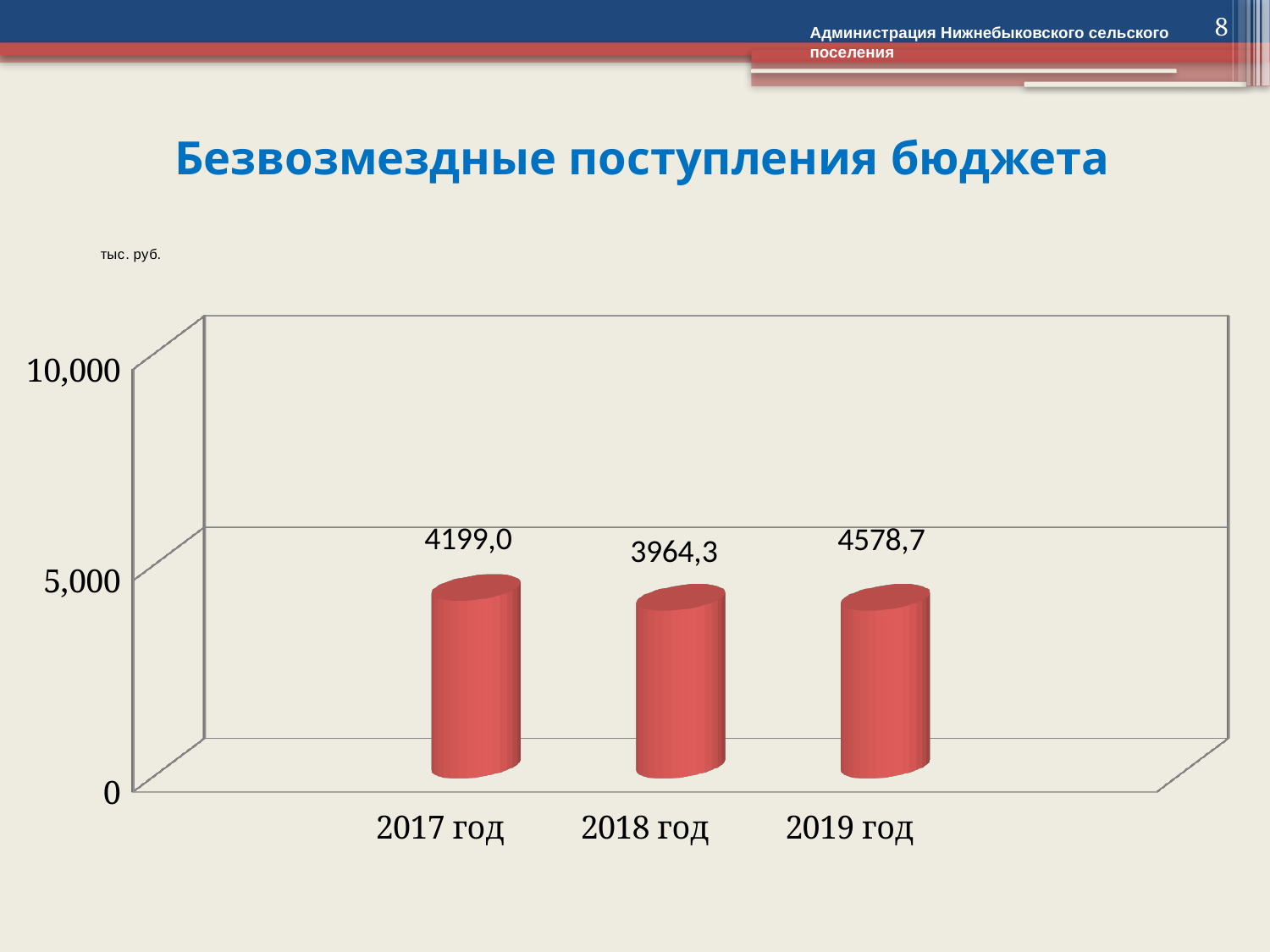
What is the difference between the values for 2019 год and 2017 год? 379,7 Is the value for 2019 год greater or less than 5,000? less Which is larger, the value for 2017 год or the value for 2018 год? 2017 год What is the title of the chart? Безвозмездные поступления бюджета What is the value for 2019 год? 4578,7 Which year has the highest value? 2019 год What kind of chart is shown on the slide? bar chart What is the difference between the values for 2017 год and 2018 год? 234,7 What is the value for 2017 год? 4199,0 How many years are shown on the chart? 3 Which year has the lowest value? 2018 год What is the value for 2018 год? 3964,3